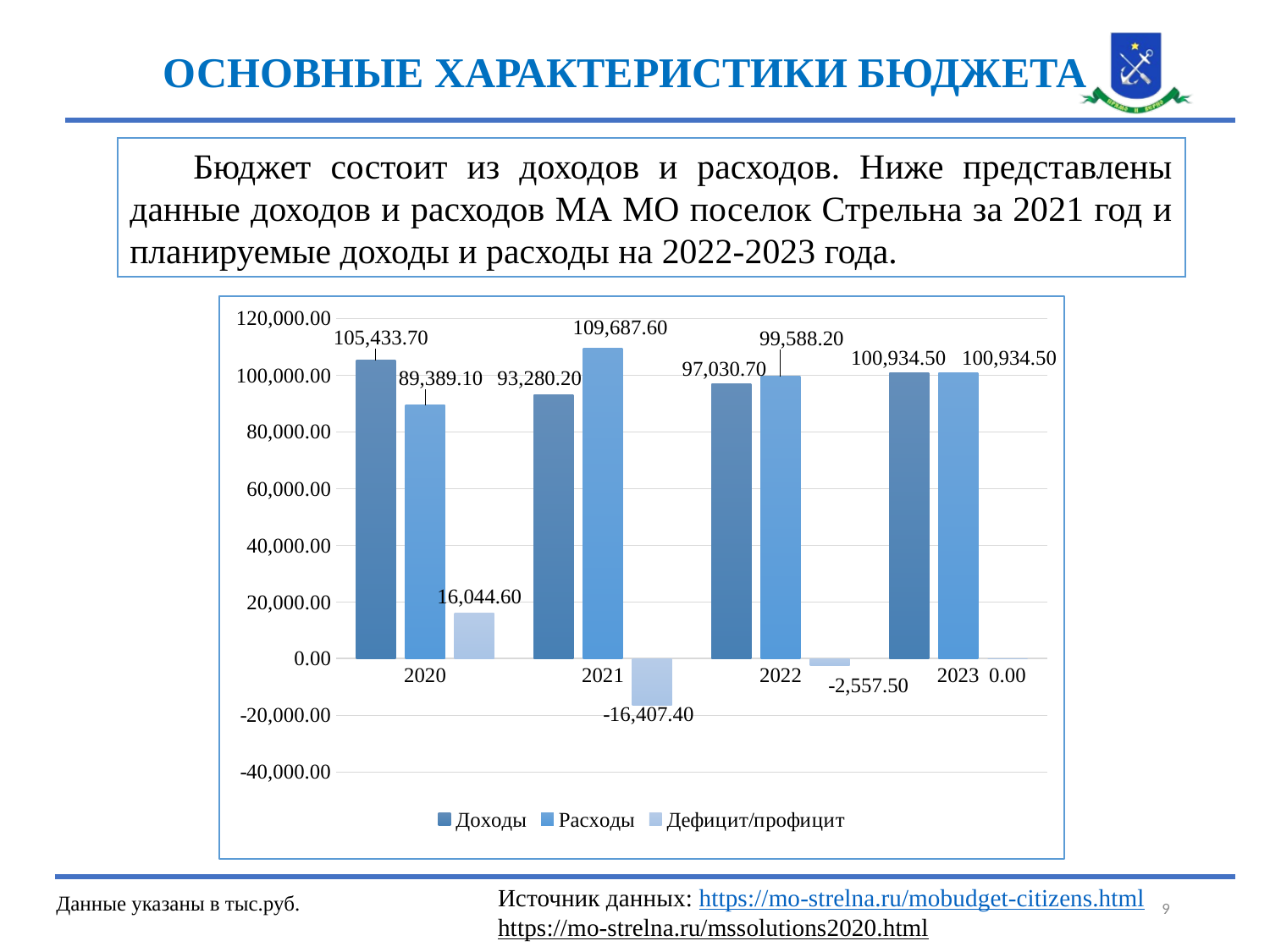
What is the value of Доходы for 2020? 105,433.70 What is the value of Расходы for 2021? 109,687.60 What is the value of Дефицит/профицит for 2023? 0.00 What type of chart is shown on the slide? bar chart Which series is shown in the lightest blue colour in the legend? Дефицит/профицит How many series does the legend list? 3 How many years (categories) are shown on the x axis? 4 Which is larger in 2022, Доходы or Расходы? Расходы What is the difference between Доходы and Расходы in 2020? 16,044.60 In which year is Доходы the lowest? 2021 What is the value of Дефицит/профицит for 2022? -2,557.50 In which year is Расходы the highest? 2021